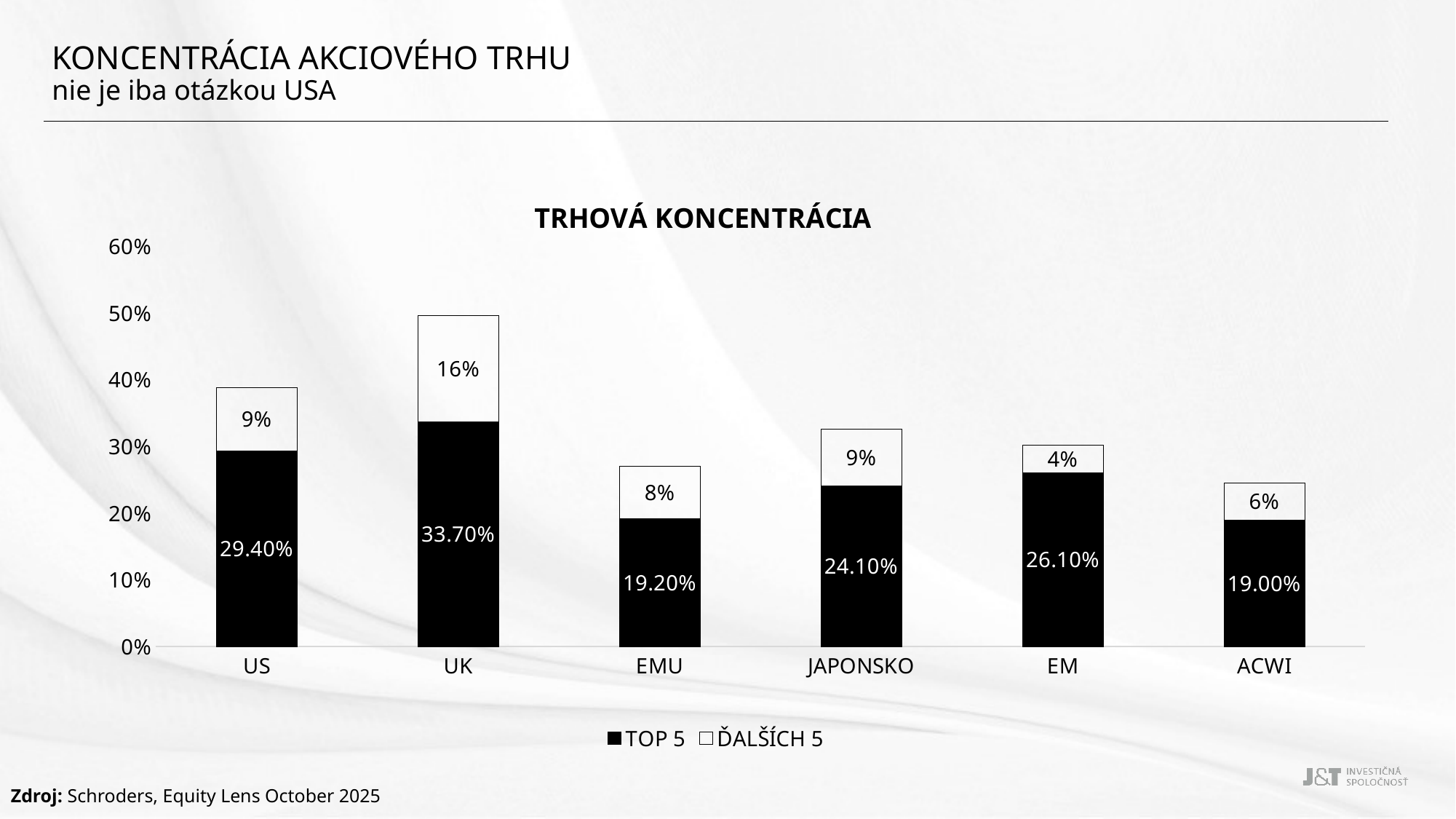
What is the TOP 5 value for the UK? 33.70% Is the total stacked bar for the UK greater or less than 40%? greater Which has a larger TOP 5 value, EM or EMU? EM What is the ĎALŠÍCH 5 value for the UK? 16% How many categories are shown on the x axis? 6 What type of chart is shown on the slide? stacked bar chart What is the ĎALŠÍCH 5 value for EM? 4% Which category has the highest TOP 5 value? UK Which category has the lowest TOP 5 value? ACWI What is the TOP 5 value for JAPONSKO? 24.10% How many series does the legend list? 2 What is the difference between the TOP 5 values for the UK and the US? 4.30%